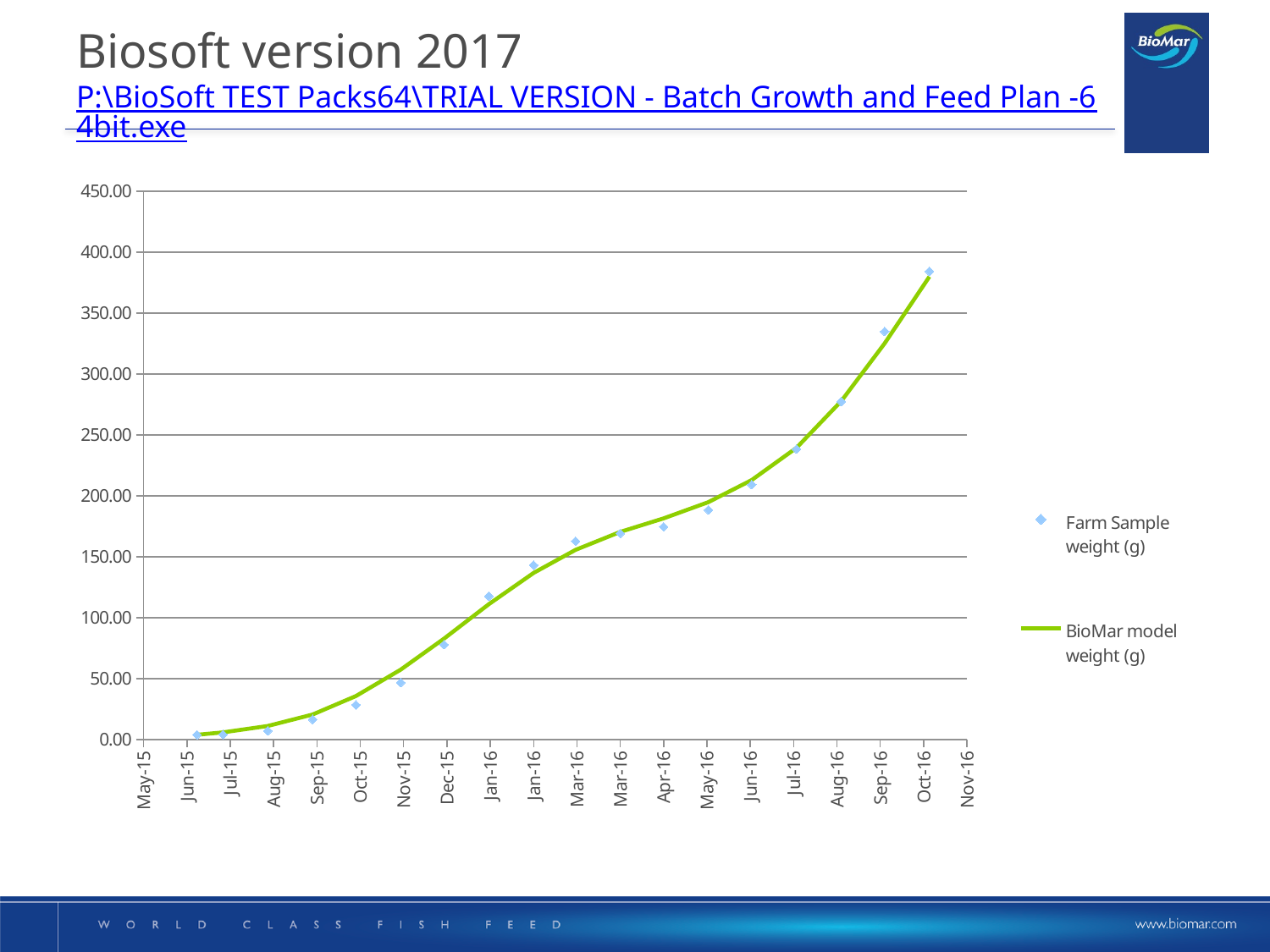
At which month is the Farm Sample weight (g) lowest? Jun-15 Which is larger, the Farm Sample weight (g) for Sep-16 or for Oct-16? Oct-16 What are the two series named in the legend? Farm Sample weight (g) and BioMar model weight (g) What colour is the BioMar model weight (g) line? green Do the weight values rise or fall from Jun-15 to Oct-16? rise How many series does the legend list? 2 Is the Farm Sample weight (g) for Dec-15 greater or less than 100? less Is the Farm Sample weight (g) for Oct-16 greater or less than 350? greater Is the Farm Sample weight (g) for Aug-16 greater or less than 250? greater At which month is the Farm Sample weight (g) highest? Oct-16 What is the highest value shown on the vertical axis? 450.00 What kind of chart is shown on the slide? line chart